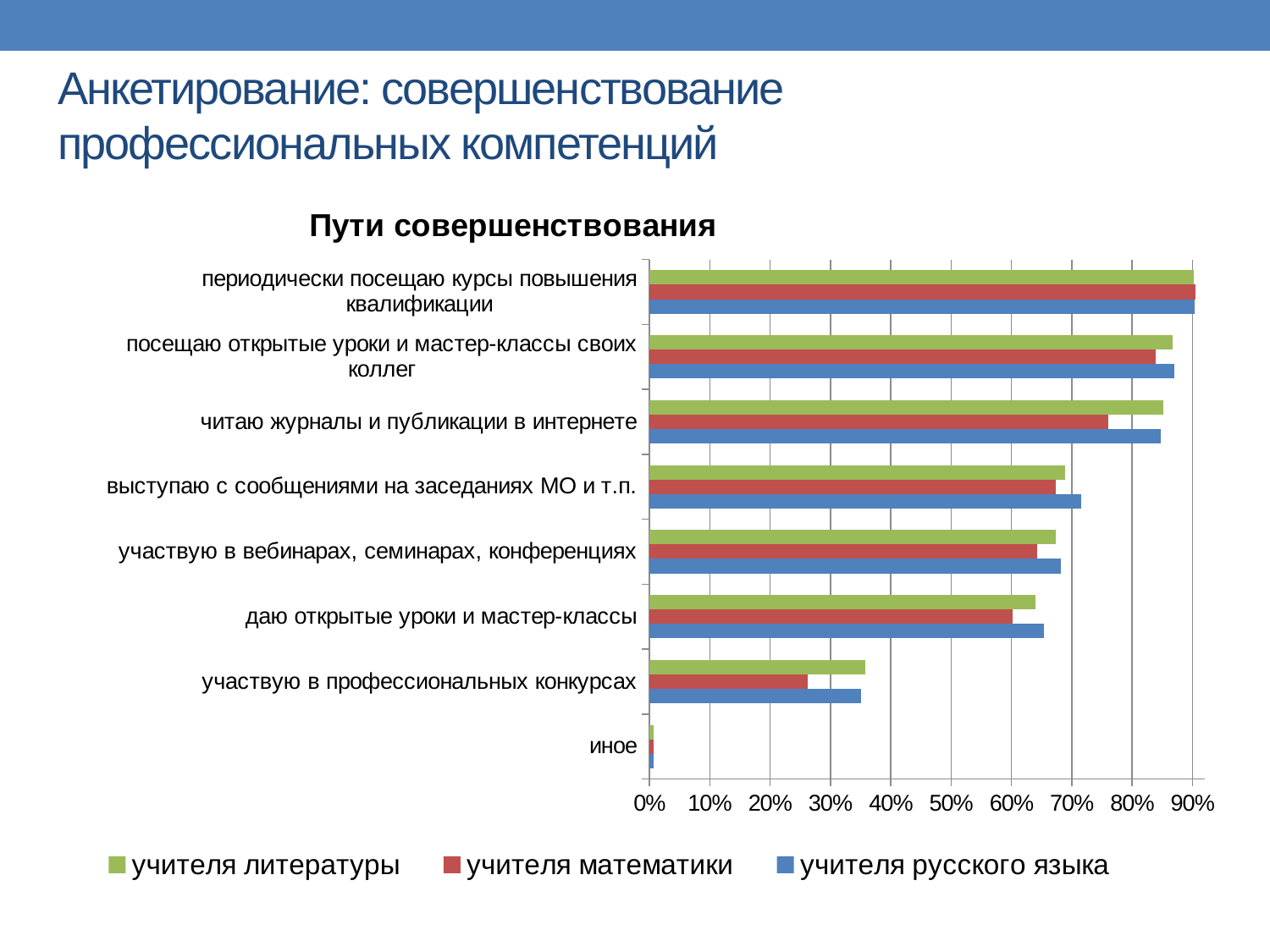
What colour represents учителя русского языка in the chart? blue Which category has the lowest value for учителя русского языка? иное In the category 'читаю журналы и публикации в интернете', which series has the larger value: учителя литературы or учителя математики? учителя литературы Is the value for учителя математики in the category 'участвую в профессиональных конкурсах' greater or less than 30%? less How many categories are plotted on the chart? 8 What is the title of the chart? Пути совершенствования Which category has the highest value for учителя математики? периодически посещаю курсы повышения квалификации Is the value for учителя математики in the category 'читаю журналы и публикации в интернете' greater or less than 70%? greater How many series does the legend list? 3 What kind of chart is shown on the slide? bar chart In the category 'участвую в профессиональных конкурсах', which series has the larger value: учителя литературы or учителя математики? учителя литературы Is the value for учителя русского языка in the category 'даю открытые уроки и мастер-классы' greater or less than 60%? greater